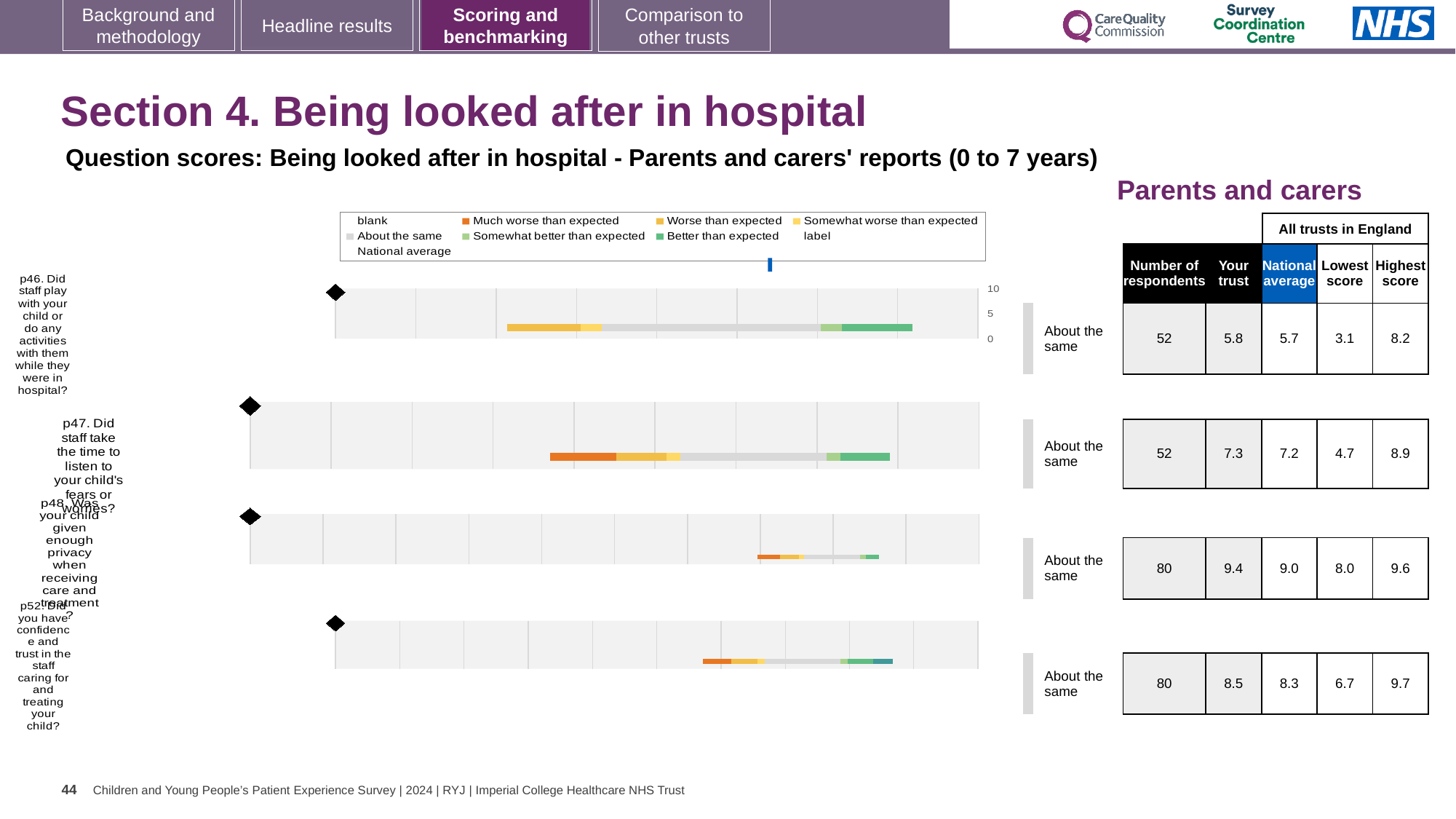
What is the lowest score across all trusts in England for p46? 3.1 For p47, what is the difference between the 'Your trust' score and the national average? 0.1 What kind of chart is used to show the question scores on this slide? Bar chart According to the table, what is the national average score for p47 (Did staff take the time to listen to your child's fears or worries)? 7.2 Which question has the lowest 'Your trust' score in the table? p46 What is the highest score across all trusts in England for p52 (Did you have confidence and trust in the staff caring for and treating your child)? 9.7 What benchmark category is shown next to the bar for p46? About the same For p52, which is larger: the 'Your trust' score or the national average? Your trust How many respondents are listed for p48 (Was your child given enough privacy when receiving care and treatment)? 80 How many questions (p46, p47, p48, p52) are plotted as bars on this slide? 4 Which question has the highest 'Your trust' score in the table? p48 According to the table, what is the 'Your trust' score for p46 (Did staff play with your child or do any activities with them while they were in hospital)? 5.8